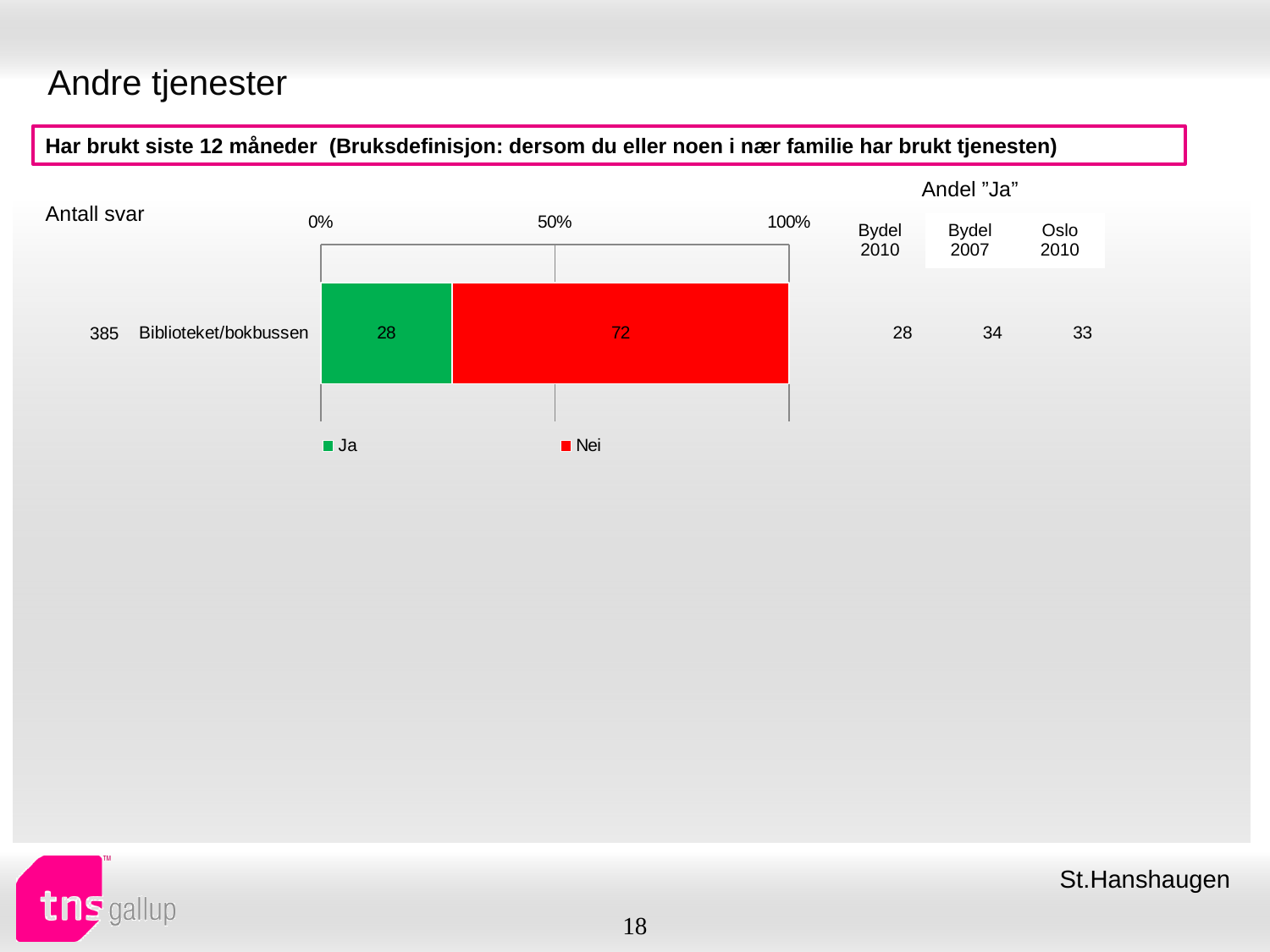
What colour represents the "Ja" series in the chart? Green Which segment is larger for Biblioteket/bokbussen, Ja or Nei? Nei What is the number of responses (Antall svar) for Biblioteket/bokbussen? 385 What is the Andel "Ja" value for Bydel 2007? 34 What is the value of the "Ja" segment for Biblioteket/bokbussen? 28 How many series does the legend list? 2 What is the value of the "Nei" segment for Biblioteket/bokbussen? 72 What is the difference between the Nei and Ja values for Biblioteket/bokbussen? 44 What kind of chart is shown on the slide? Stacked bar chart What is the total of the stacked bar for Biblioteket/bokbussen? 100 How many categories are plotted in the chart? 1 Is the Nei value for Biblioteket/bokbussen greater or less than 50%? greater